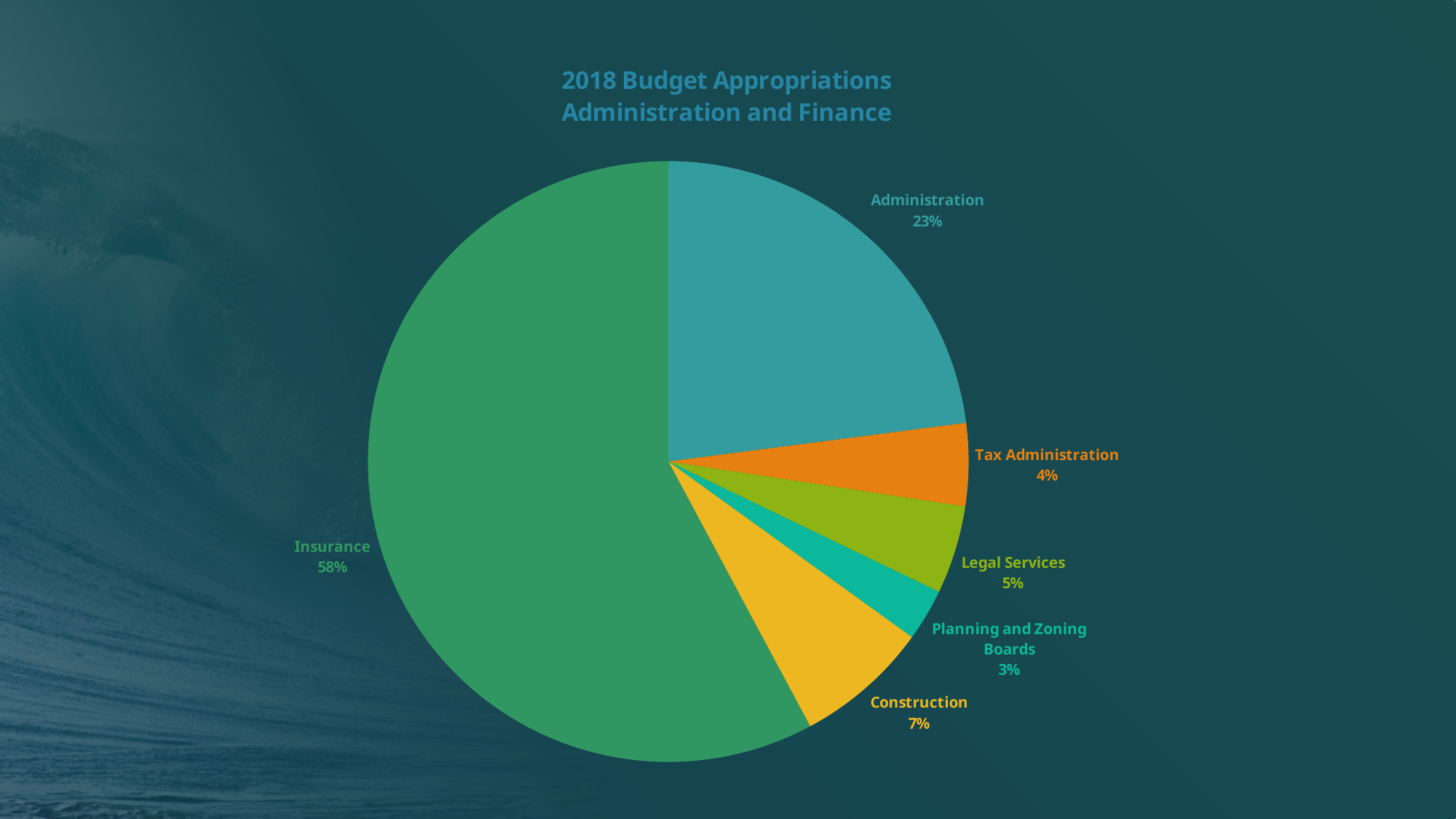
What is the combined share of Construction and Legal Services? 12% What is the difference between the Insurance share and the Administration share? 35% What is the value shown for Administration? 23% What share of the pie does Insurance represent? 58% Which category has the largest slice of the pie? Insurance What is the value shown for Construction? 7% What is the value shown for Planning and Zoning Boards? 3% What is the title of the chart? 2018 Budget Appropriations Administration and Finance How many categories are shown in the pie chart? 6 Which is larger, Legal Services or Tax Administration? Legal Services Which category has the smallest slice of the pie? Planning and Zoning Boards What kind of chart is shown on the slide? Pie chart